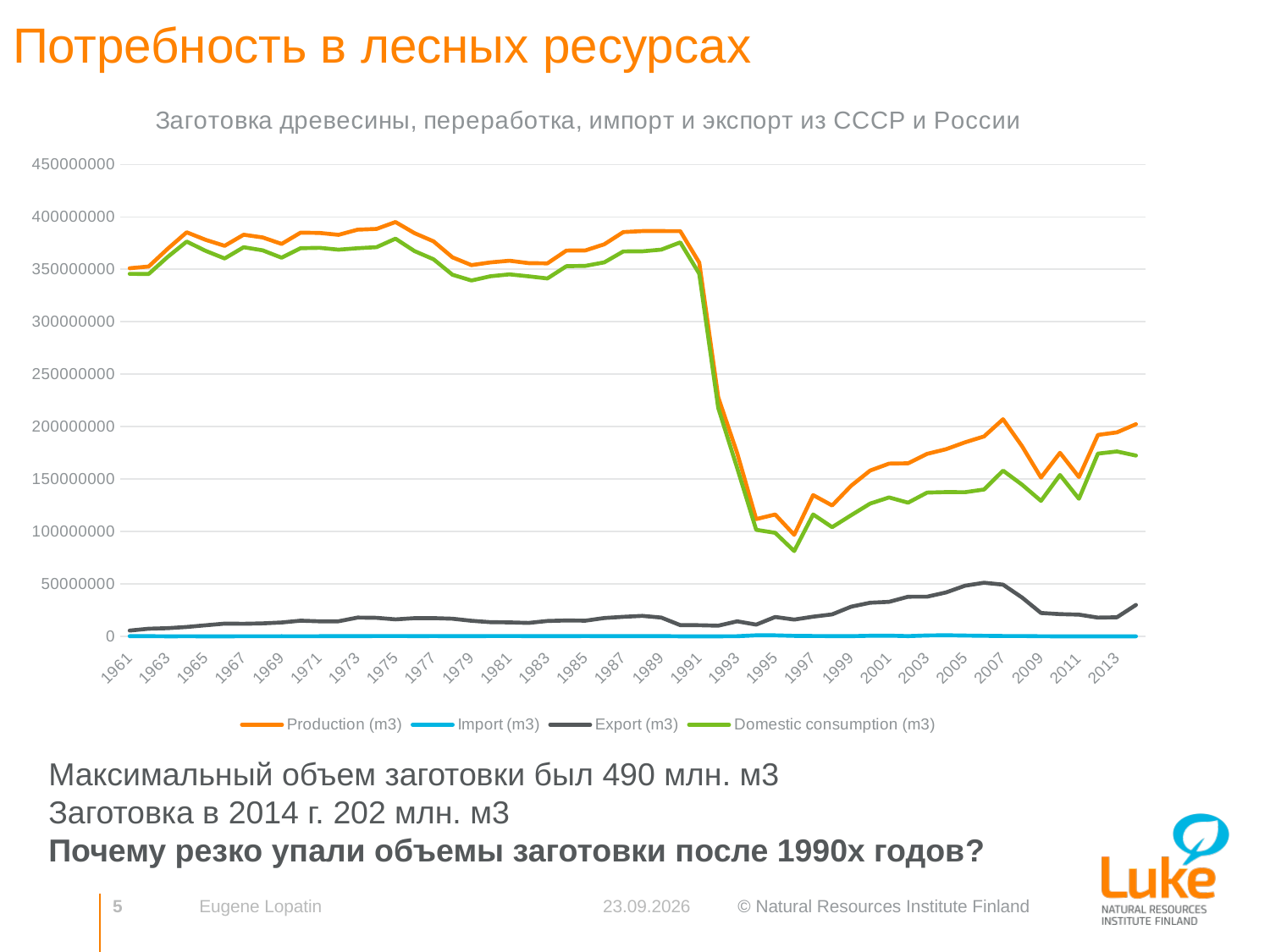
What is the title of the chart? Заготовка древесины, переработка, импорт и экспорт из СССР и России Is the value for Production (m3) in 1975 greater or less than 350000000? greater Is the value for Production (m3) in 1997 greater or less than 150000000? less How many series does the chart legend list? 4 Does the Production (m3) line rise or fall between 1991 and 1997? fall Which series has the lowest values throughout the chart? Import (m3) In 2005, which is larger: Export (m3) or Import (m3)? Export (m3) In 1965, which is larger: Production (m3) or Domestic consumption (m3)? Production (m3) Is the value for Export (m3) in 2007 greater or less than 100000000? less Which series is shown in orange in the chart legend? Production (m3) What kind of chart is shown on the slide? line chart